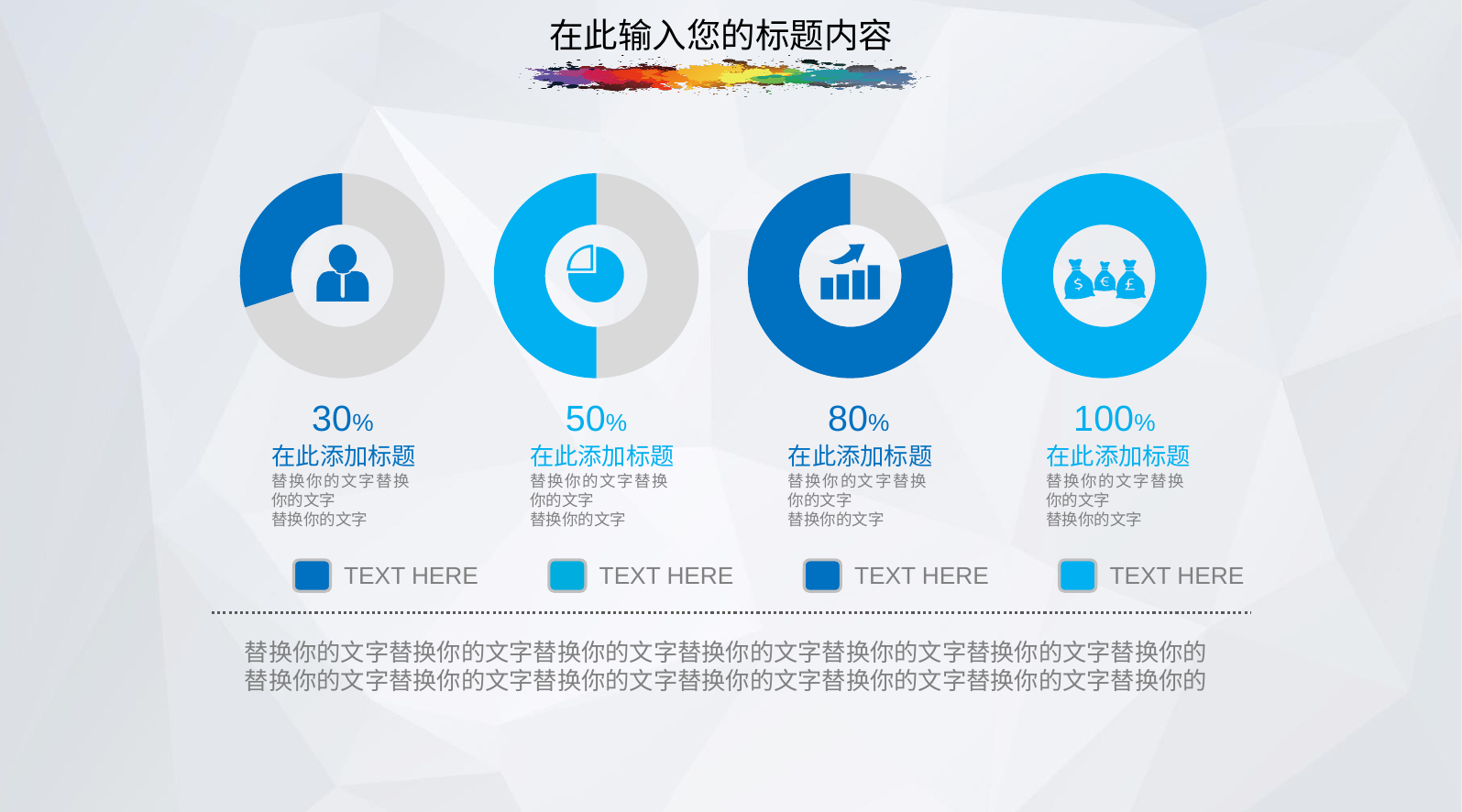
What percentage is shown below the leftmost donut chart? 30% What is the difference between the percentage of the rightmost donut chart and the percentage of the second donut chart? 50% What is the difference between the percentage of the third donut chart and the percentage of the leftmost donut chart? 50% What percentage is shown below the second donut chart from the left? 50% How many donut charts are on the slide? 4 Which is larger: the percentage of the second donut chart or the percentage of the third donut chart? the third donut chart What kind of chart is used for each of the four percentage graphics on the slide? donut chart What percentage is shown below the third donut chart from the left? 80% Which donut chart shows the highest percentage, by position on the slide? the rightmost Do the percentages increase or decrease from the leftmost donut chart to the rightmost? increase Which donut chart shows the lowest percentage, by position on the slide? the leftmost What percentage is shown below the rightmost donut chart? 100%